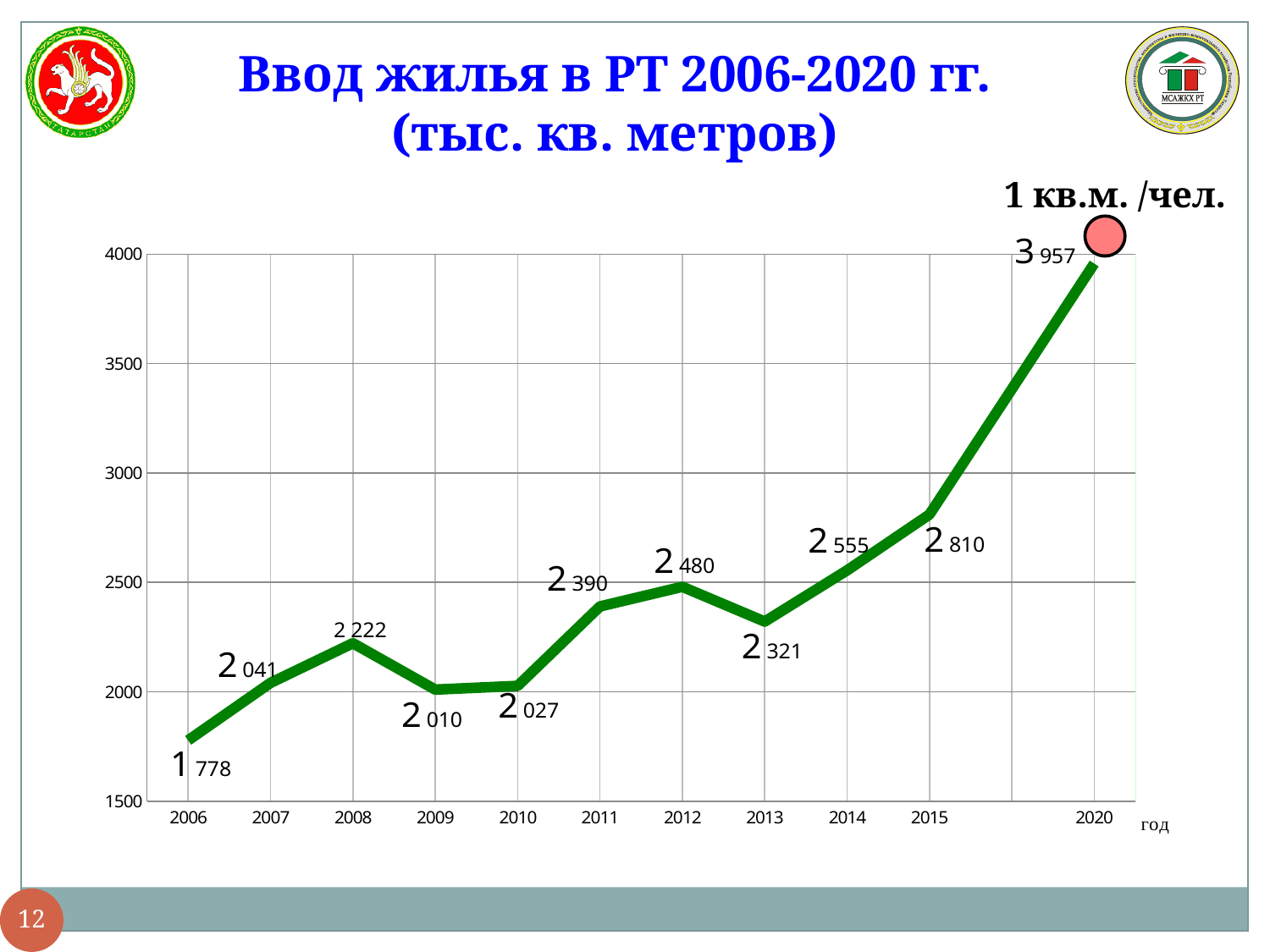
Which year has the lowest value? 2006 How many years are plotted on the chart? 11 What is the title of the chart? Ввод жилья в РТ 2006-2020 гг. (тыс. кв. метров) Which is larger, the value for 2012 or the value for 2013? 2012 What is the difference between the values for 2008 and 2007? 181 Which year has the highest value? 2020 What is the value for 2006? 1 778 What is the value for 2009? 2 010 What type of chart is shown on the slide? line chart What is the value for 2013? 2 321 What is the value for 2020? 3 957 What is the difference between the values for 2020 and 2015? 1 147